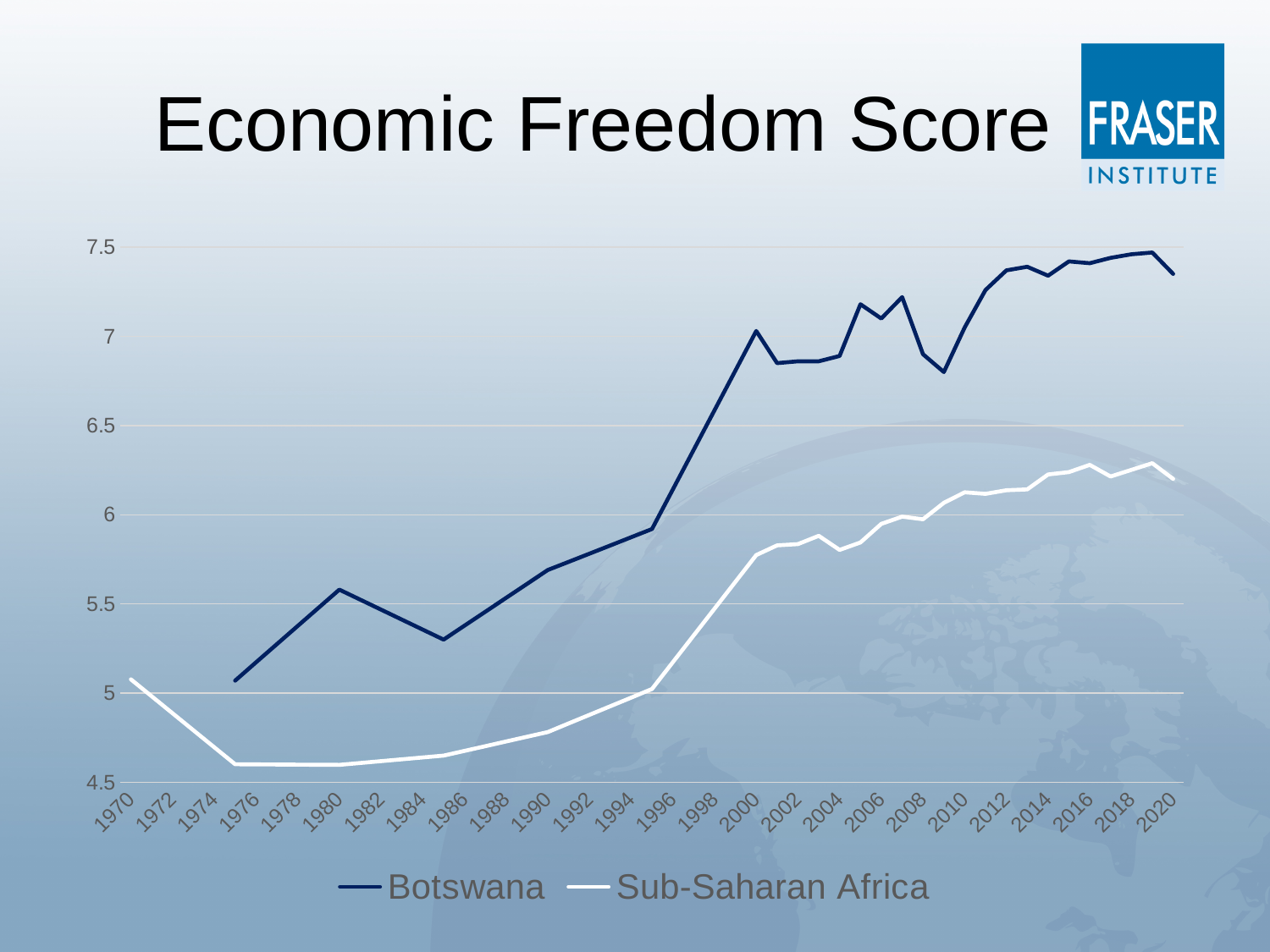
Which series is drawn with the white line? Sub-Saharan Africa What kind of chart is shown on the slide? line chart Is the value for Sub-Saharan Africa in 1976 greater or less than 5? less Does the Botswana line rise or fall between 1996 and 2000? rise Is the value for Sub-Saharan Africa in 2020 greater or less than 6? greater In 2020, which series has the higher value, Botswana or Sub-Saharan Africa? Botswana Does the Sub-Saharan Africa line rise or fall between 1970 and 1976? fall What is the title of the chart? Economic Freedom Score How many series does the legend list? 2 Is the value for Botswana in 1986 greater or less than 5.5? less